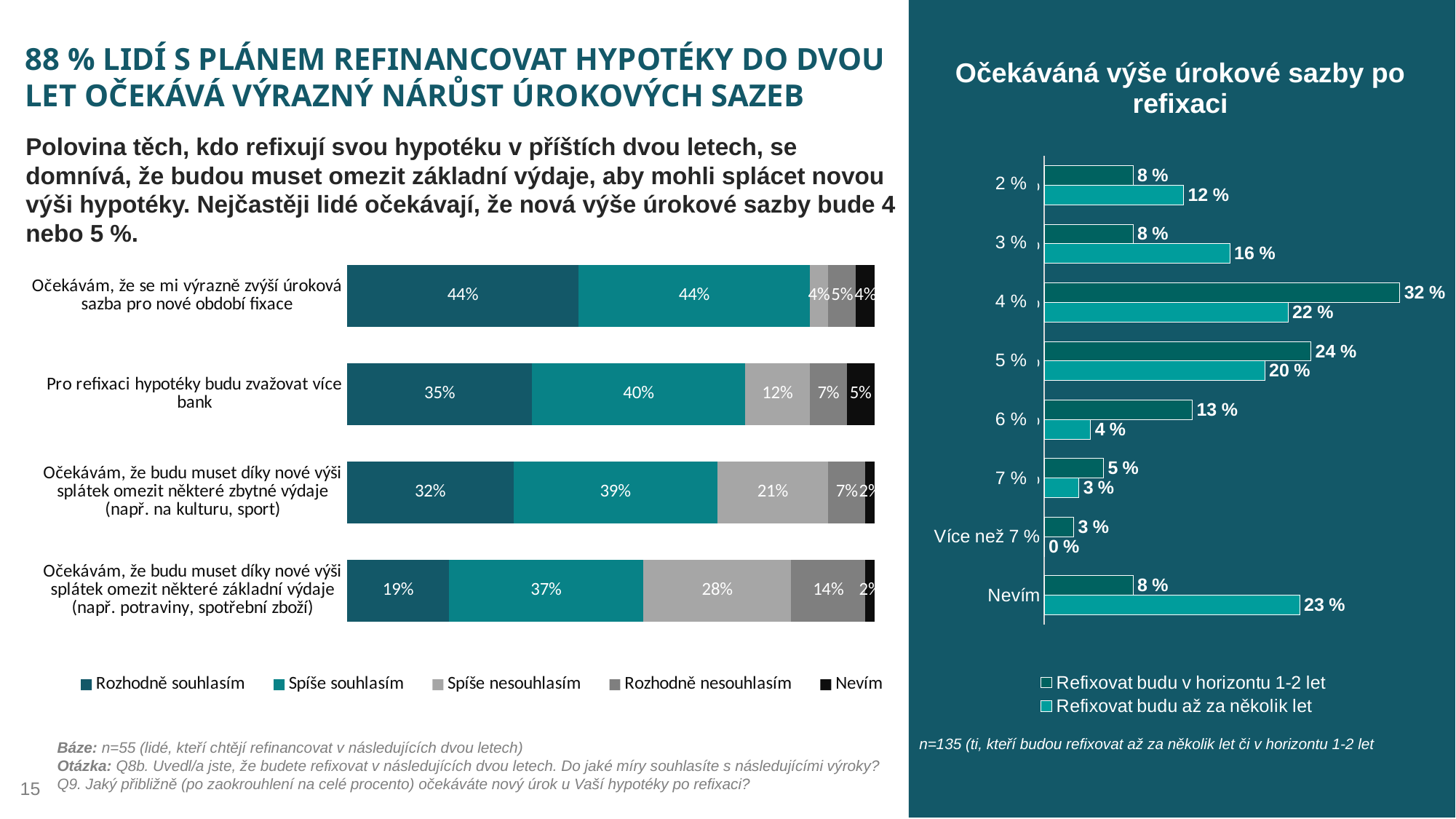
In the chart titled "Očekávaná výše úrokové sazby po refixaci", what is the value for "4 %" in the series "Refixovat budu v horizontu 1-2 let"? 32 % In the chart titled "Očekávaná výše úrokové sazby po refixaci", how many categories are shown on the axis? 8 In the stacked bar chart on the left of the slide, how many series does the legend list? 5 In the chart titled "Očekávaná výše úrokové sazby po refixaci", what is the value for "Nevím" in the series "Refixovat budu až za několik let"? 23 % In the stacked bar chart on the left of the slide, what is the "Rozhodně souhlasím" value for "Pro refixaci hypotéky budu zvažovat více bank"? 35% In the chart titled "Očekávaná výše úrokové sazby po refixaci", how many series does the legend list? 2 In the chart titled "Očekávaná výše úrokové sazby po refixaci", what is the difference between the two series for the category "4 %"? 10 % In the stacked bar chart on the left of the slide, what is the "Spíše nesouhlasím" value for the statement about limiting basic expenses ("omezit některé základní výdaje")? 28% In the chart titled "Očekávaná výše úrokové sazby po refixaci", which category has the lowest value in the series "Refixovat budu až za několik let"? Více než 7 % In the stacked bar chart on the left of the slide, which statement has the highest "Rozhodně souhlasím" value? Očekávám, že se mi výrazně zvýší úroková sazba pro nové období fixace In the chart titled "Očekávaná výše úrokové sazby po refixaci", for the category "6 %", which series has the larger value? Refixovat budu v horizontu 1-2 let In the chart titled "Očekávaná výše úrokové sazby po refixaci", which category has the highest value in the series "Refixovat budu v horizontu 1-2 let"? 4 %